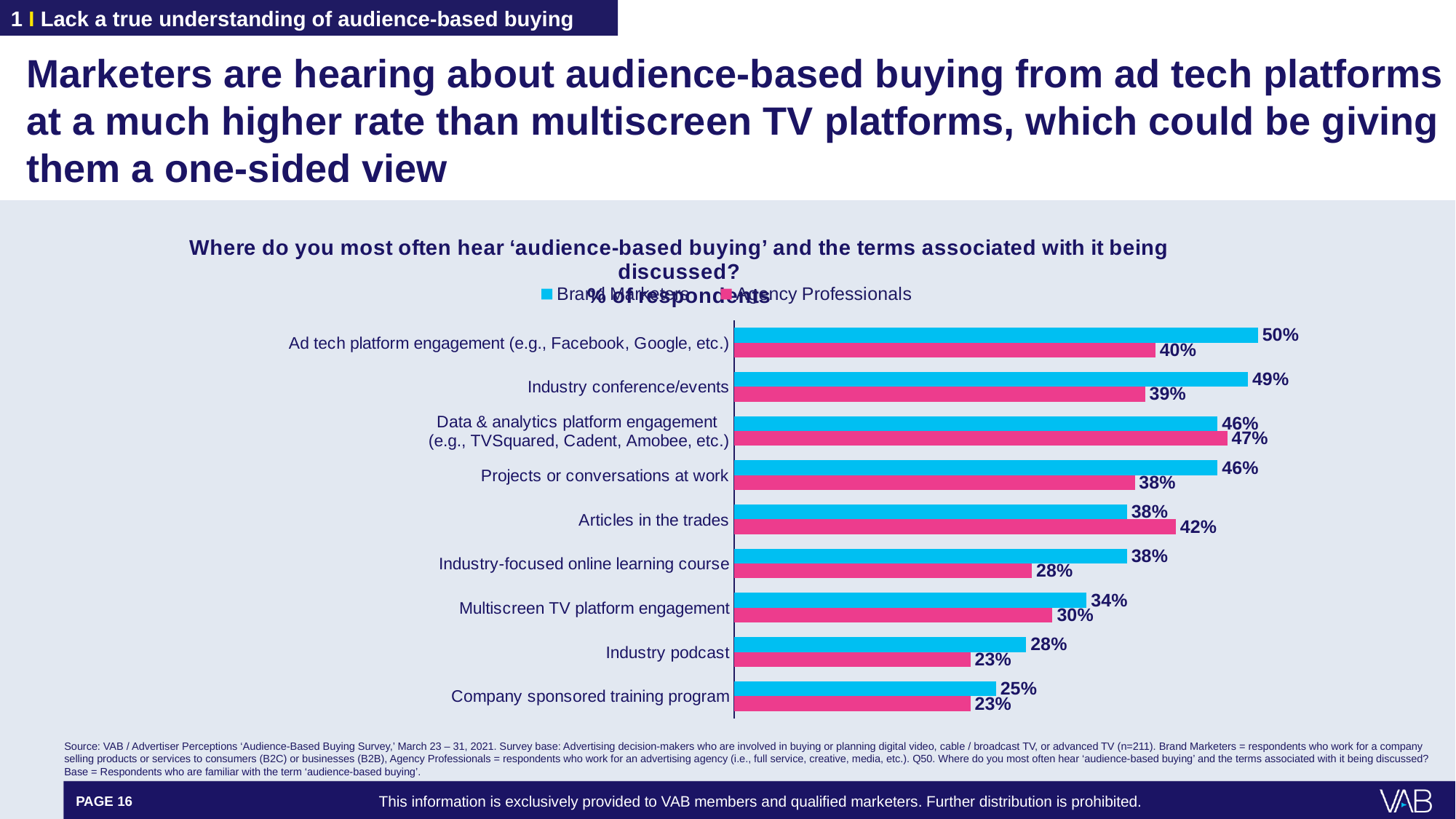
What is the Agency Professionals value for 'Articles in the trades'? 42% What percentage of Agency Professionals most often hear 'audience-based buying' discussed through multiscreen TV platform engagement? 30% Which category has the highest value for Brand Marketers? Ad tech platform engagement (e.g., Facebook, Google, etc.) What percentage of Brand Marketers most often hear 'audience-based buying' discussed through ad tech platform engagement? 50% Which category has the lowest value for Brand Marketers? Company sponsored training program Which category has the highest value for Agency Professionals? Data & analytics platform engagement (e.g., TVSquared, Cadent, Amobee, etc.) What type of chart is shown on the slide? Bar chart For 'Industry podcast', which group has the larger value, Brand Marketers or Agency Professionals? Brand Marketers What is the difference between the Brand Marketers and Agency Professionals values for 'Industry-focused online learning course'? 10 percentage points For 'Articles in the trades', which group has the larger value, Brand Marketers or Agency Professionals? Agency Professionals How many categories are shown in the chart? 9 How many series does the chart's legend list? 2